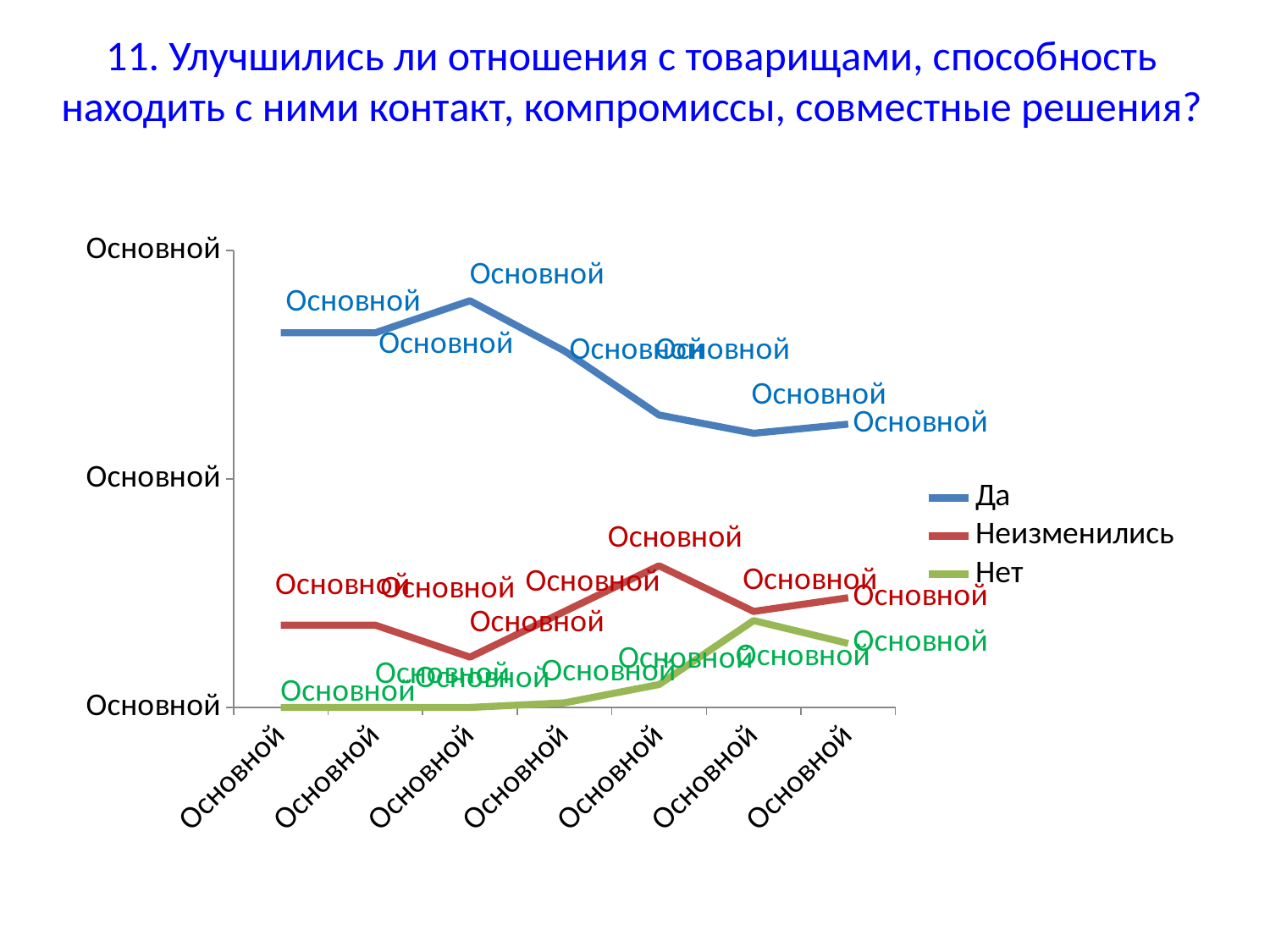
What kind of chart is shown on the slide? line chart How many data points does each line have along the x axis? 7 Which series has the lowest values across the whole chart? Нет What are the three legend entries of the chart? Да, Неизменились, Нет Which series has the highest values across the whole chart? Да Does the "Да" line rise or fall overall from left to right? fall How many series does the legend list? 3 Does the "Нет" line rise or fall overall from left to right? rise Which series is drawn in red? Неизменились